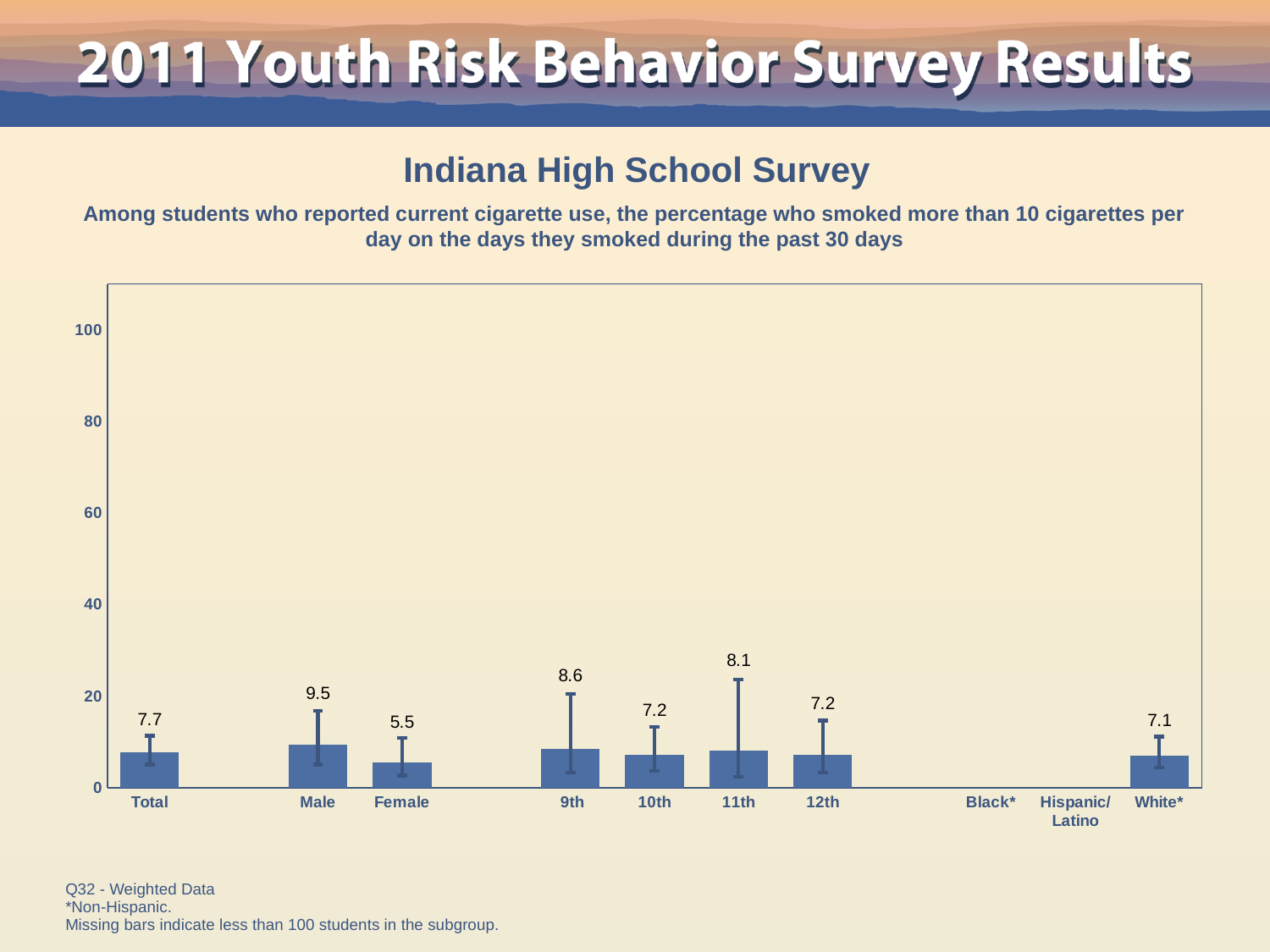
What kind of chart is shown? bar chart What is the value for Male? 9.5 Which category has the lowest value among those with bars? Female How many categories are labeled on the x axis? 10 What is the value for Total? 7.7 Which is larger, the value for 9th grade or the value for 12th grade? 9th What is the value for White*? 7.1 Which category has the highest value? Male What is the difference between the Male and Female values? 4.0 What is the value for 11th grade? 8.1 What is the value for Female? 5.5 Is the value for Male greater or less than 20? less